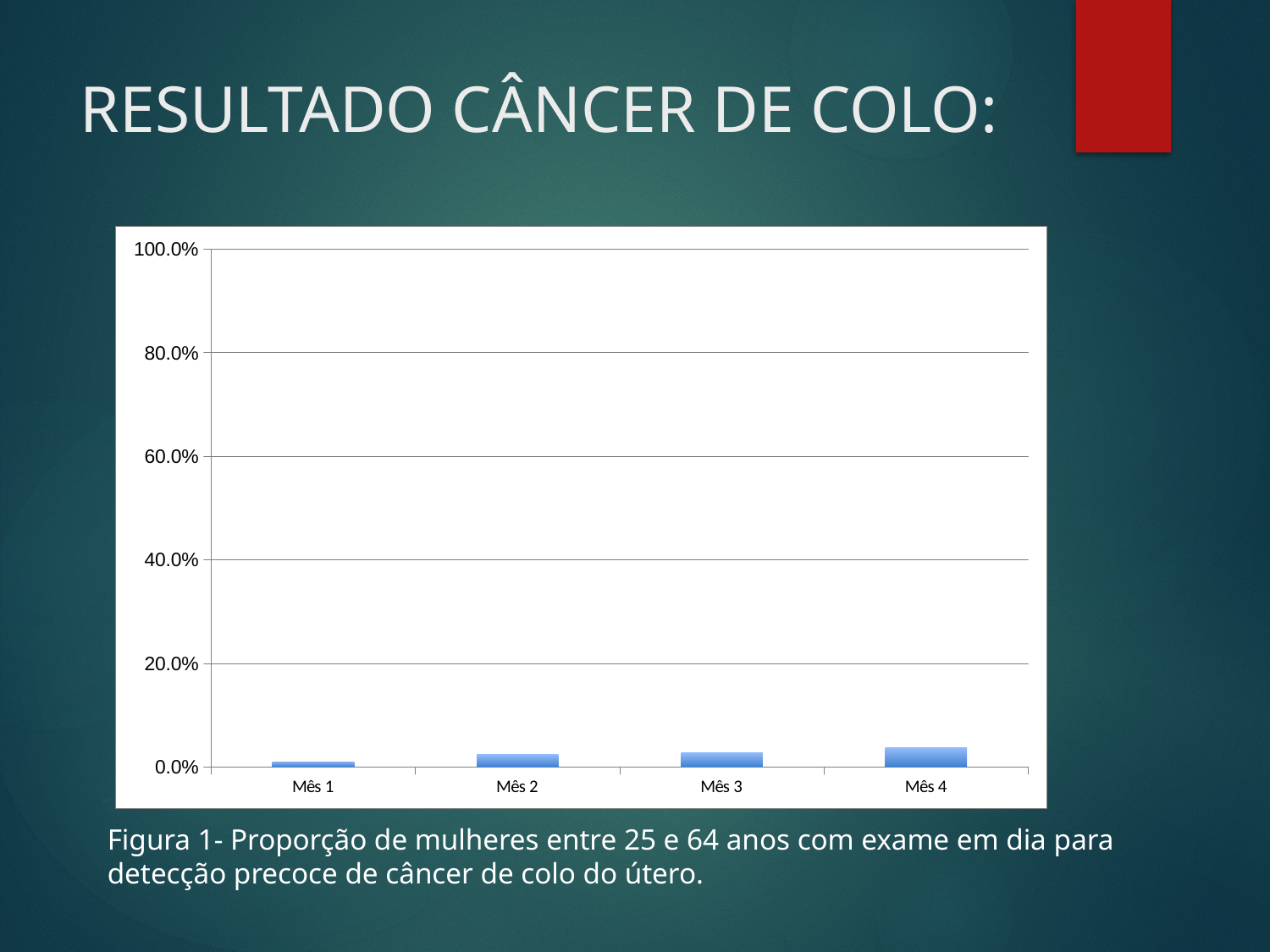
Which month has the lowest bar in the chart? Mês 1 Which is larger, the value for Mês 1 or the value for Mês 4? Mês 4 Which month has the highest bar in the chart? Mês 4 What kind of chart is shown on the slide? bar chart What is the figure number given in the caption below the chart? Figura 1 Do the bar values rise or fall from Mês 1 to Mês 4? rise Is the value for Mês 4 greater or less than 20.0%? less How many categories (months) are shown on the x axis of the chart? 4 What is the highest value shown on the y axis of the chart? 100.0% Is the value for Mês 1 greater or less than 20.0%? less Which is larger, the value for Mês 2 or the value for Mês 4? Mês 4